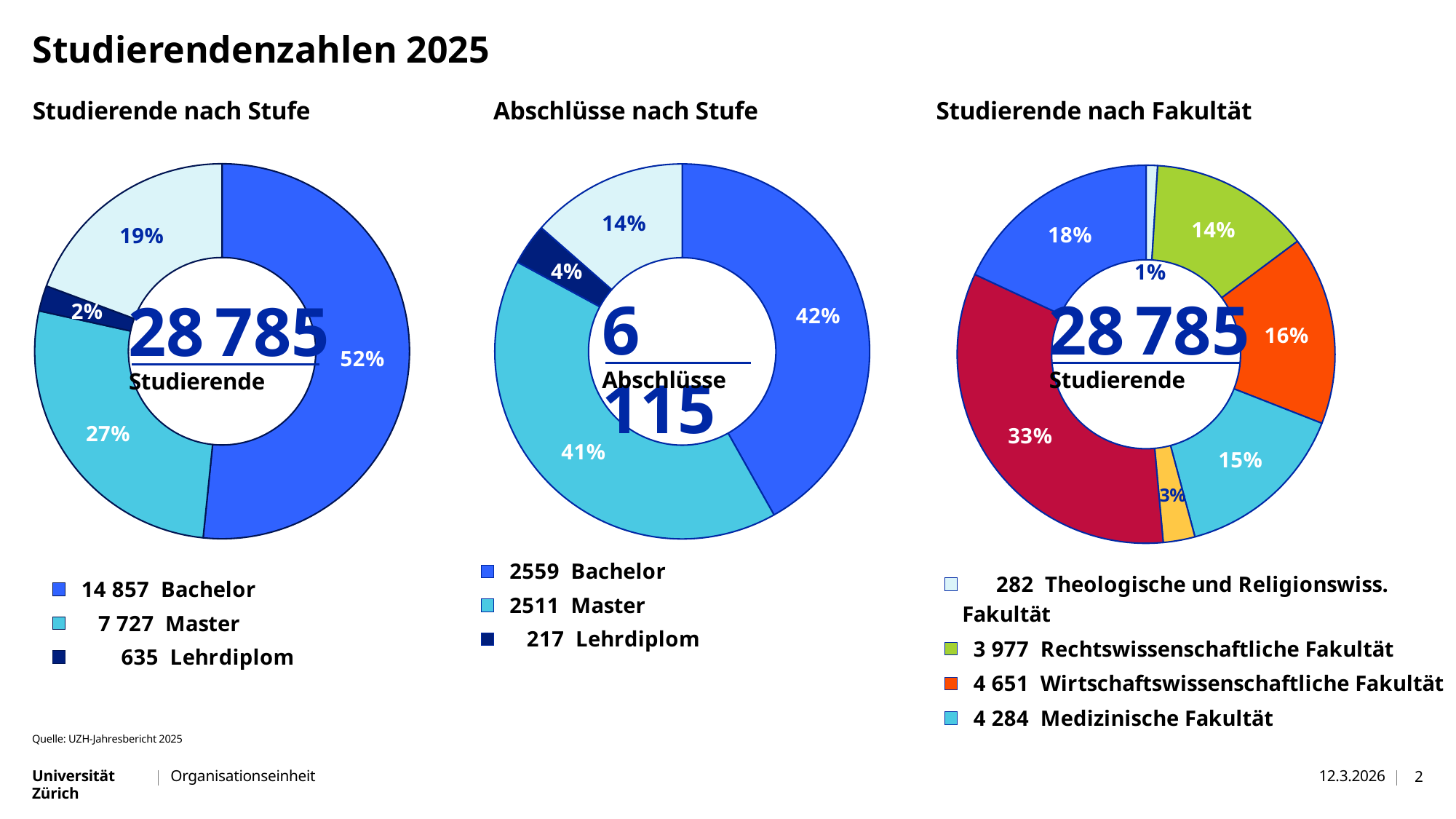
In the 'Studierende nach Stufe' chart, what percentage of students are Bachelor students? 52% How many entries does the legend of the 'Studierende nach Fakultät' chart list? 4 In the 'Studierende nach Fakultät' chart, how many students does the Medizinische Fakultät have? 4 284 In the 'Studierende nach Stufe' chart, which category has the largest slice? Bachelor In the 'Abschlüsse nach Stufe' chart, how many Lehrdiplom degrees are listed? 217 What type of chart is used for 'Abschlüsse nach Stufe'? Donut (pie) chart In the 'Studierende nach Stufe' chart, what is the difference between the number of Bachelor and Master students? 7 130 In the 'Abschlüsse nach Stufe' chart, which is larger, the number of Bachelor degrees or the number of Master degrees? Bachelor In the 'Studierende nach Fakultät' chart, how many more students does the Wirtschaftswissenschaftliche Fakultät have than the Medizinische Fakultät? 367 In the 'Studierende nach Fakultät' chart, which faculty listed in the legend has the smallest number of students? Theologische und Religionswiss. Fakultät How many slices does the 'Studierende nach Fakultät' chart have? 7 In the 'Studierende nach Stufe' chart, how many Master students are listed in the legend? 7 727